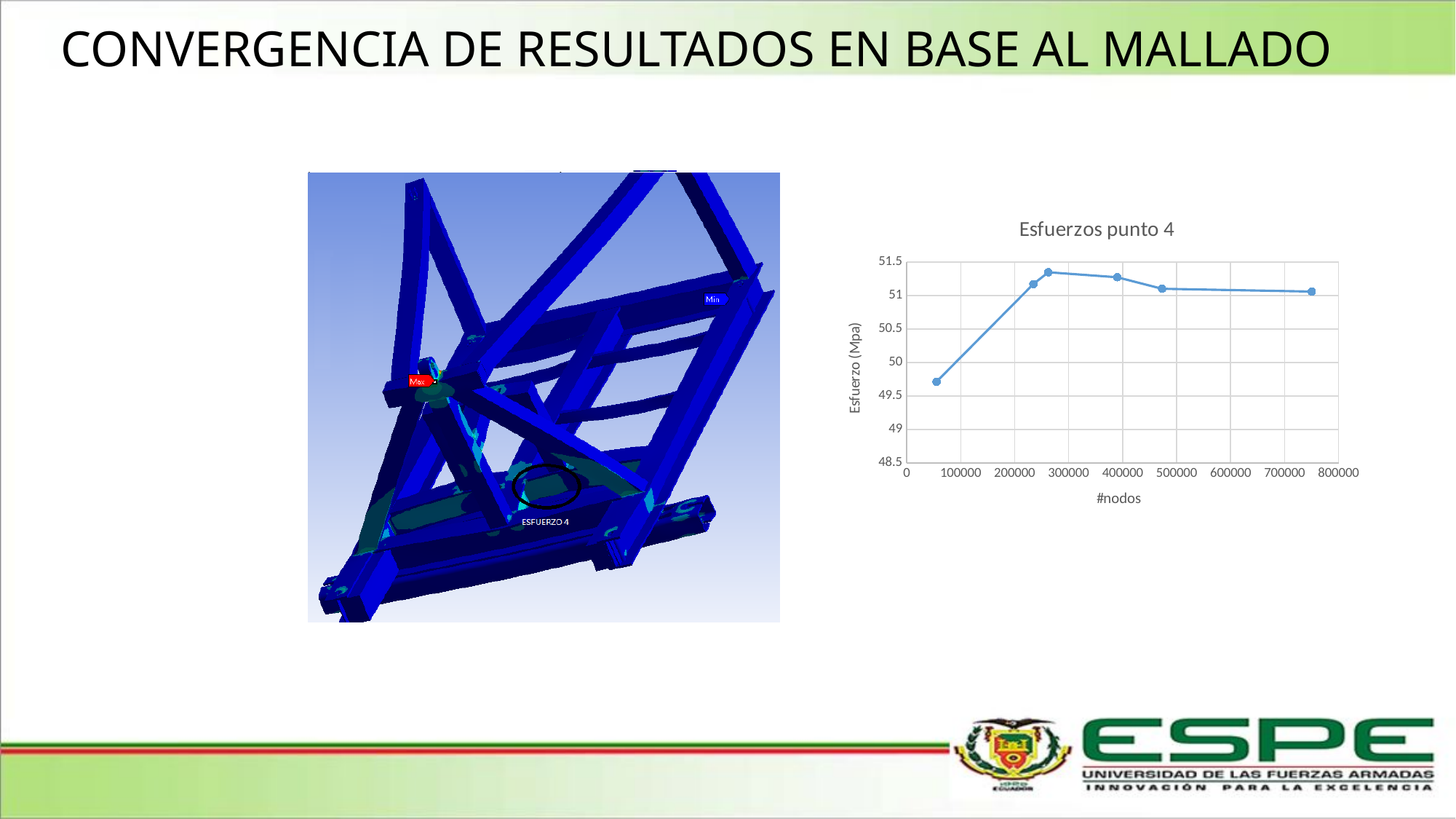
What is the title of the chart? Esfuerzos punto 4 Does the stress value rise or fall from the point near 260000 nodes to the point near 750000 nodes? fall How many data points are plotted on the chart? 6 Which data point has the lowest stress value? the first point (near 50000 nodes) Which is larger: the value at the first data point (near 50000 nodes) or the value at the last data point (near 750000 nodes)? the last data point Is the value of the data point near 260000 nodes greater or less than 51? greater Is the value of the data point near 390000 nodes greater or less than 50.5? greater Is the value of the first data point (near 50000 nodes) greater or less than 50? less What is the label of the y axis of the chart? Esfuerzo (Mpa) Does the stress value rise or fall between the first and second data points? rise What kind of chart is shown on the slide? line chart